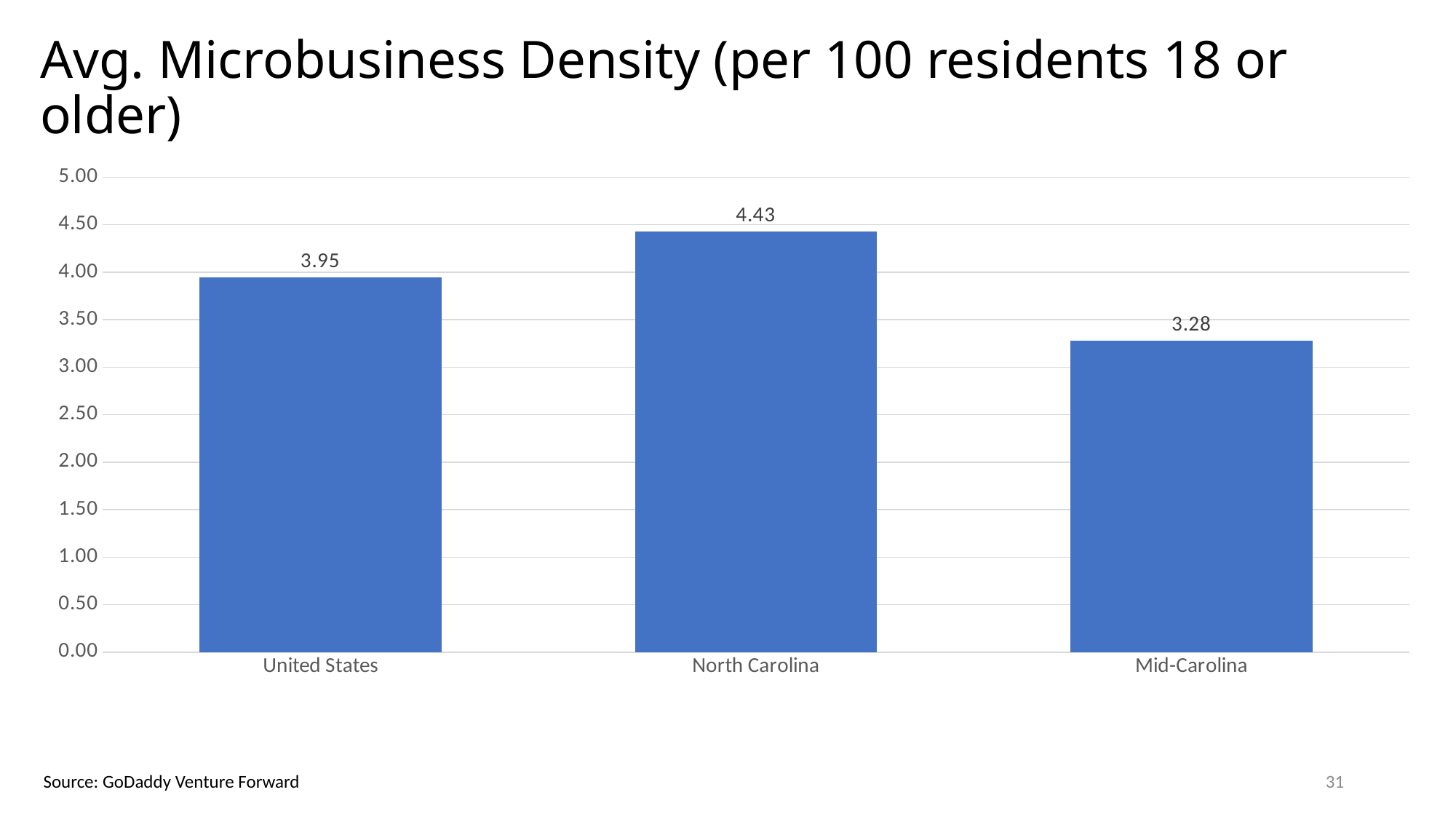
How many categories are shown on the chart? 3 What is the difference between the United States and Mid-Carolina values? 0.67 What is the average microbusiness density for North Carolina? 4.43 What is the average microbusiness density for Mid-Carolina? 3.28 What is the source cited for the chart? GoDaddy Venture Forward What is the difference between the North Carolina and United States values? 0.48 Which category has the highest average microbusiness density? North Carolina What is the average microbusiness density for the United States? 3.95 What kind of chart is shown on the slide? Bar chart Which is larger, the value for North Carolina or the value for Mid-Carolina? North Carolina Is the value for Mid-Carolina greater or less than 3.50? less Which category has the lowest average microbusiness density? Mid-Carolina